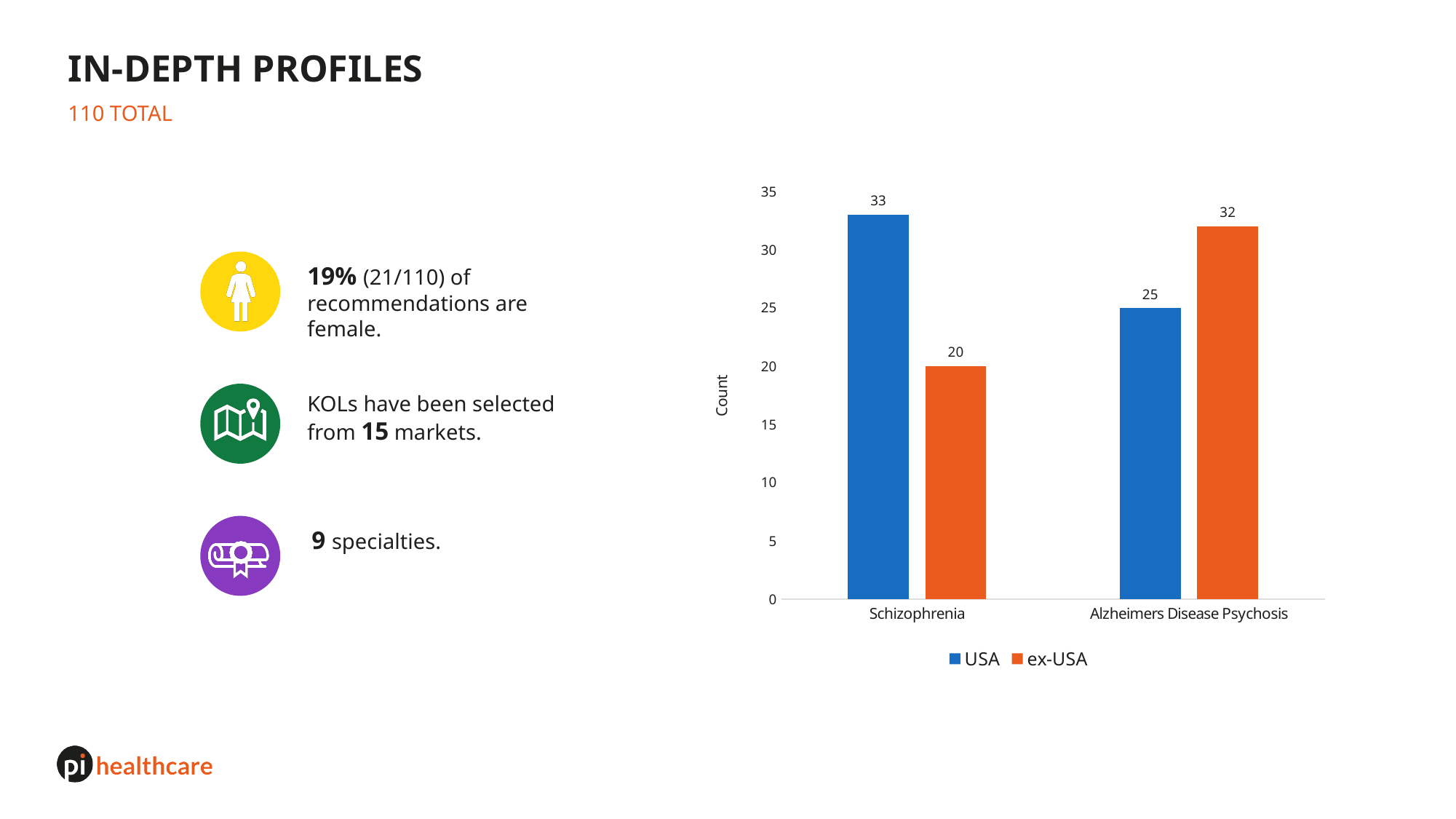
Which category has the highest USA count? Schizophrenia What is the USA count for Alzheimers Disease Psychosis? 25 What is the ex-USA count for Schizophrenia? 20 What is the ex-USA count for Alzheimers Disease Psychosis? 32 How many categories are shown on the x axis? 2 What is the USA count for Schizophrenia? 33 What is the difference between the ex-USA and USA counts for Alzheimers Disease Psychosis? 7 Which is larger for Alzheimers Disease Psychosis, the USA count or the ex-USA count? ex-USA How many series does the legend list? 2 What kind of chart is shown on the slide? Bar chart What is the difference between the USA and ex-USA counts for Schizophrenia? 13 Which category has the lowest ex-USA count? Schizophrenia